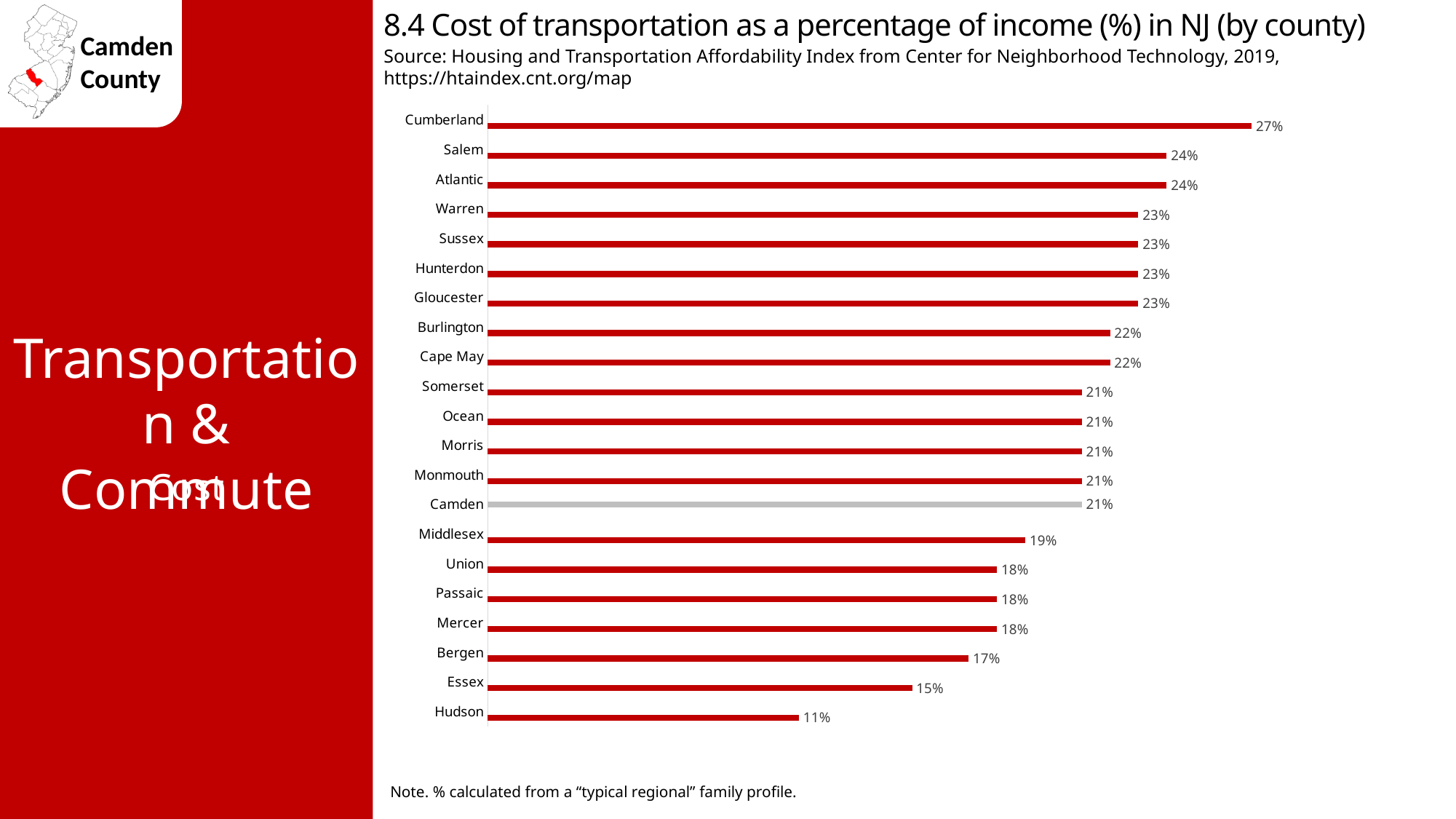
What is the difference in percentage points between Cumberland and Hudson? 16 What is the cost of transportation as a percentage of income for Camden County? 21% Which county has the highest cost of transportation as a percentage of income? Cumberland Which county's bar is shown in grey rather than red? Camden What is the cost of transportation as a percentage of income for Hudson County? 11% Which county has the lowest cost of transportation as a percentage of income? Hudson What is the value shown for Bergen County? 17% What type of chart is used on this slide? Bar chart What is the difference in percentage points between Camden and Essex? 6 What is the value shown for Cumberland County? 27% How many counties are shown in the chart? 21 Which has a higher value, Middlesex or Essex? Middlesex